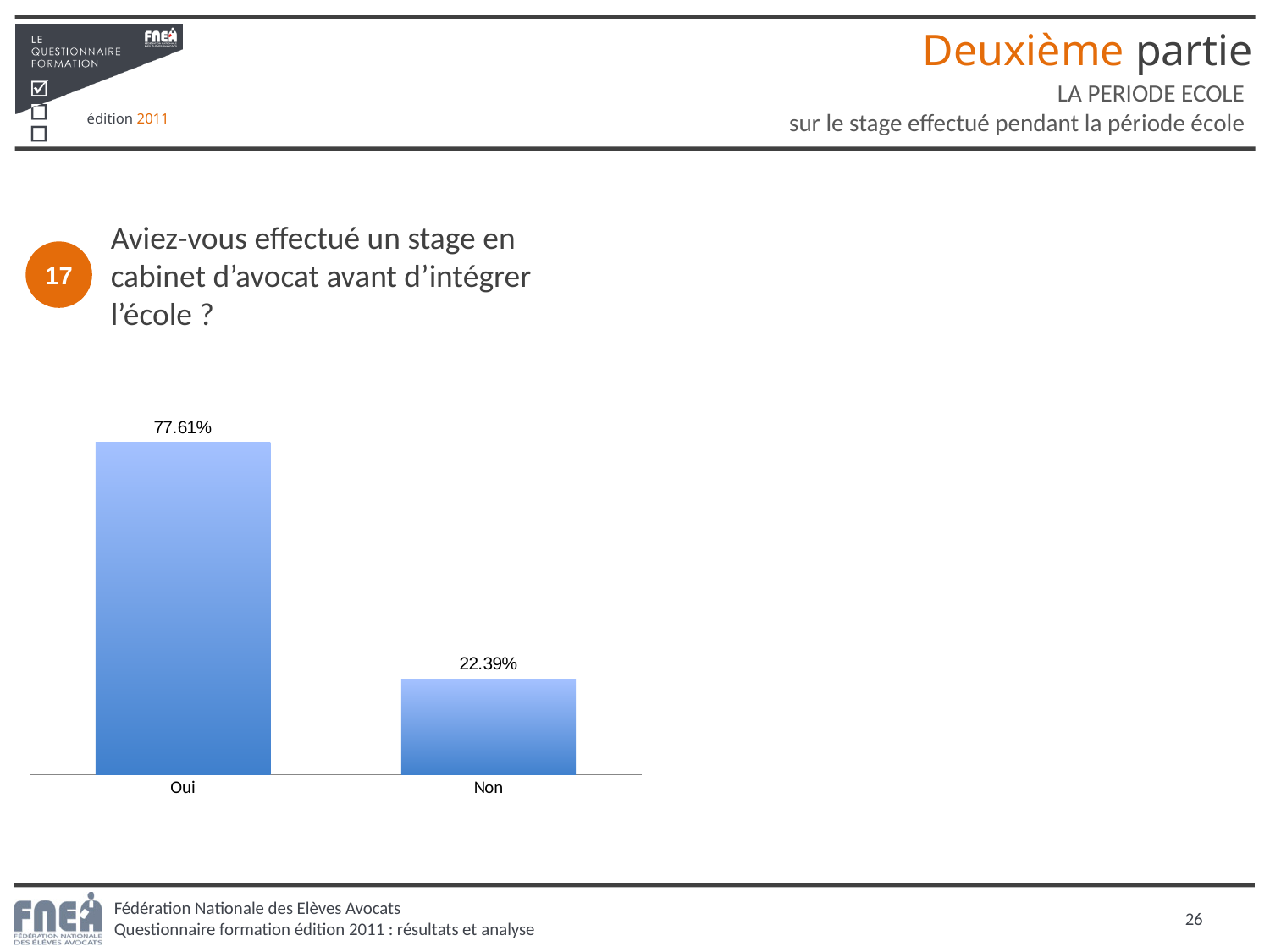
How many categories are shown in the chart? 2 What kind of chart is shown on the slide? bar chart What is the value for Oui? 77.61% Which category has the highest value? Oui What is the total of the two values shown in the chart? 100% What are the category labels on the x axis of the chart? Oui, Non What is the difference between the values for Oui and Non? 55.22% What is the value for Non? 22.39% What question number does the chart on the slide correspond to? 17 Which category has the lowest value? Non Which is larger, the value for Oui or the value for Non? Oui